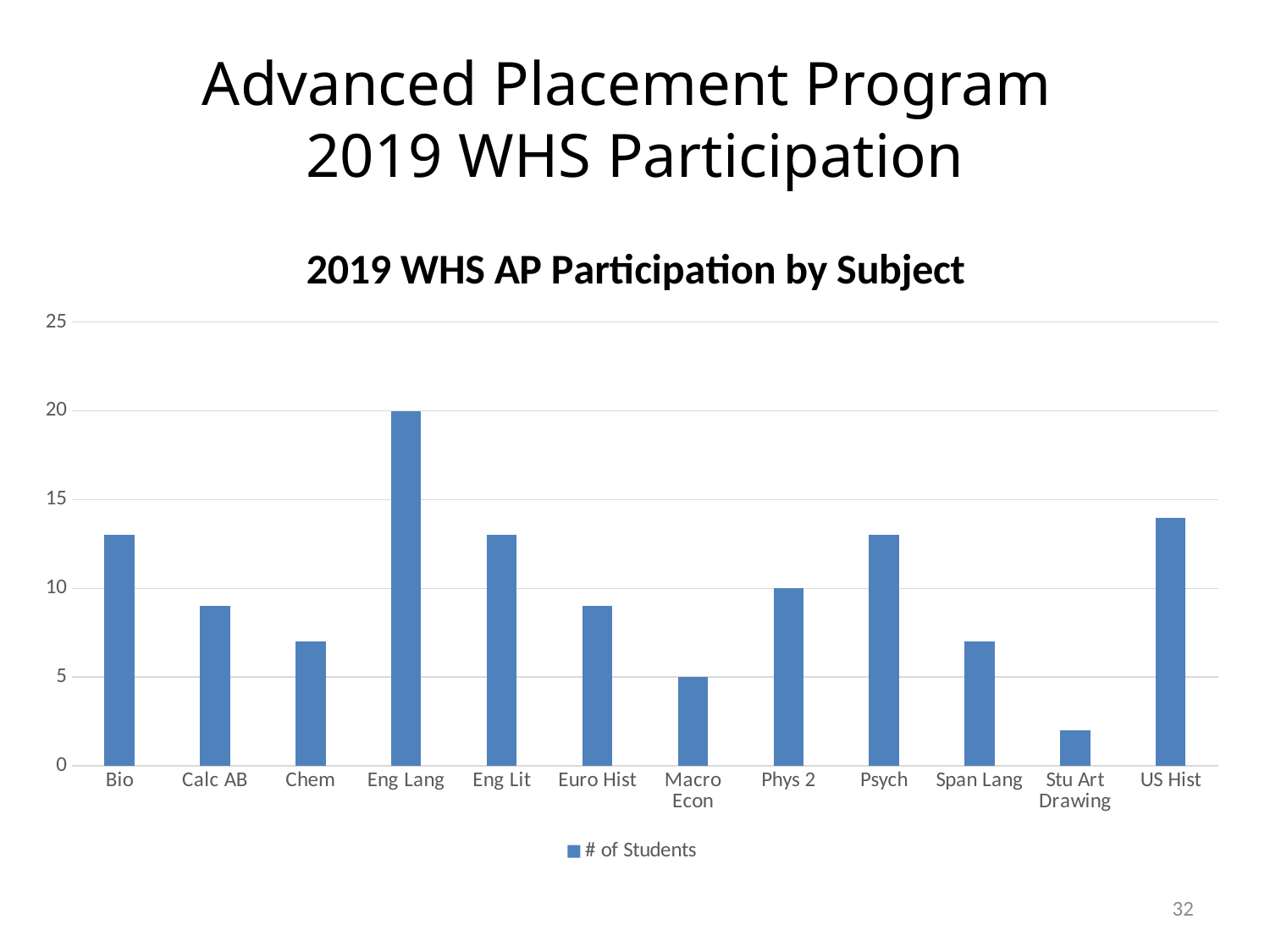
How many series does the legend list? 1 Which subject has the highest number of students? Eng Lang How many subjects are shown on the x axis of the chart? 12 What is the number of students for Macro Econ? 5 What kind of chart is shown on the slide? bar chart What is the number of students for Phys 2? 10 Which has more students, Psych or Span Lang? Psych What is the series name shown in the legend? # of Students Is the value for Bio greater or less than 10? greater What is the number of students for Eng Lang? 20 Which subject has the lowest number of students? Stu Art Drawing What is the difference in number of students between Eng Lang and Phys 2? 10